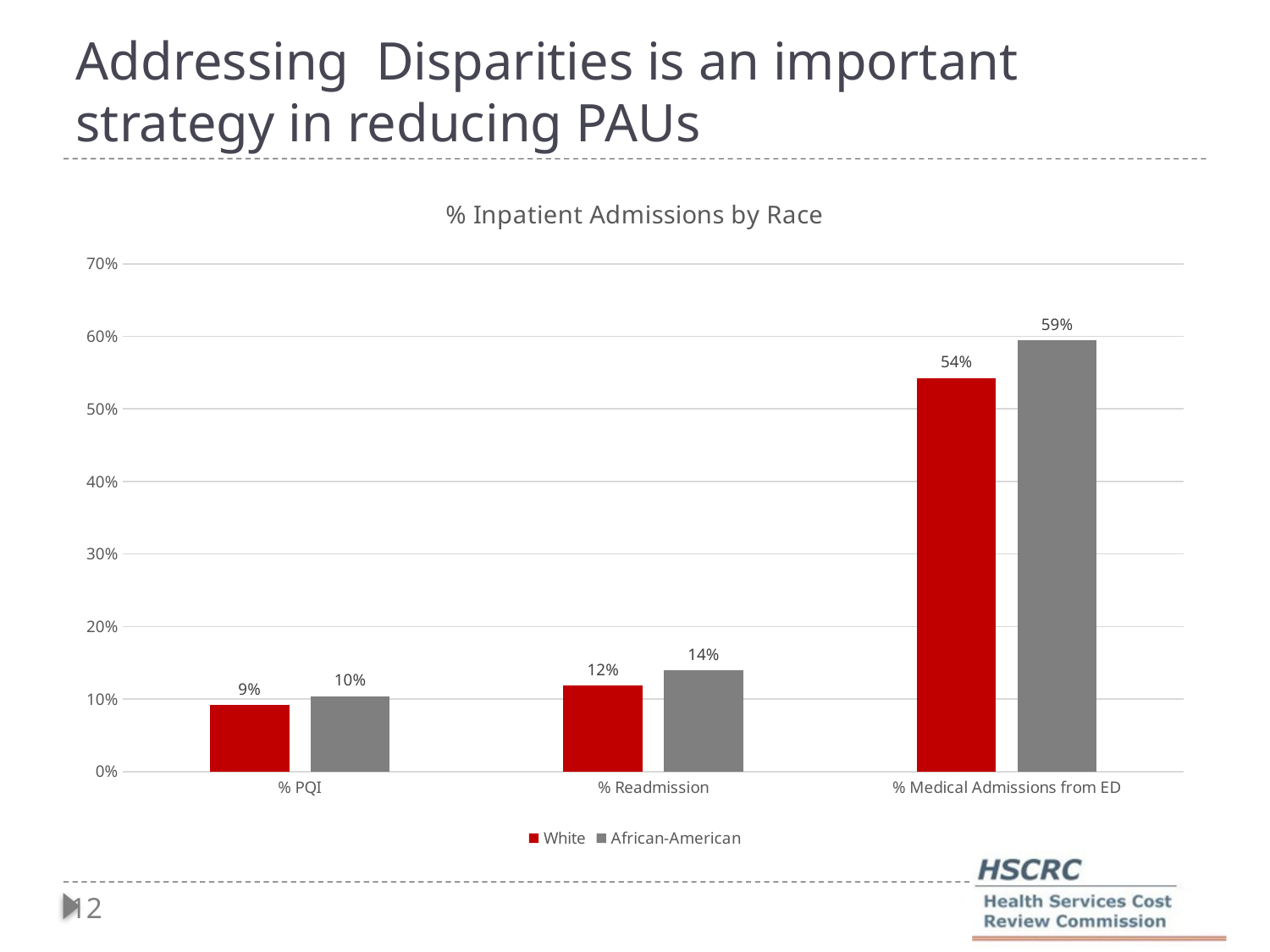
What kind of chart is shown on the slide? bar chart What is the value for White in the % Medical Admissions from ED category? 54% What is the difference between the African-American and White values in the % Medical Admissions from ED category? 5% How many categories are shown on the x axis? 3 In the % Readmission category, which series has the larger value, White or African-American? African-American How many series does the legend list? 2 Is the value for African-American in the % Medical Admissions from ED category greater or less than 50%? greater What is the title of the chart? % Inpatient Admissions by Race Which category has the lowest value for White? % PQI What is the value for African-American in the % Readmission category? 14% Which category has the highest value for African-American? % Medical Admissions from ED What is the value for White in the % PQI category? 9%